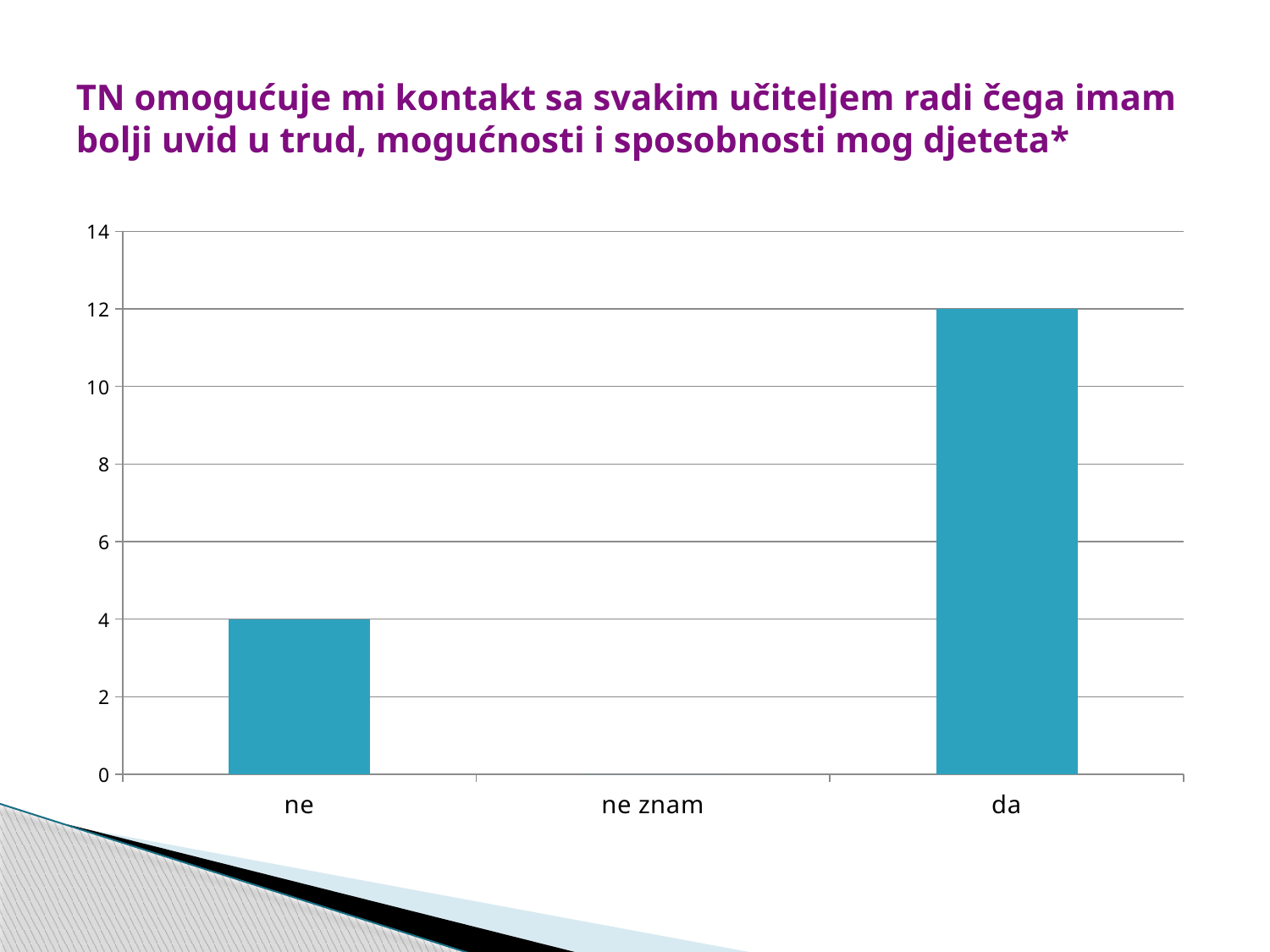
What is the value for "da"? 12 What is the value for "ne"? 4 What is the difference between the values for "da" and "ne"? 8 What is the maximum value shown on the y axis? 14 What type of chart is shown on the slide? bar chart How many categories are shown on the x axis of the chart? 3 Which category has the lowest value? ne znam Which category has the highest value? da Which is larger, the value for "ne" or the value for "da"? da What colour are the bars in the chart? blue Is the value for "ne" greater or less than 6? less Is the value for "da" greater or less than 10? greater